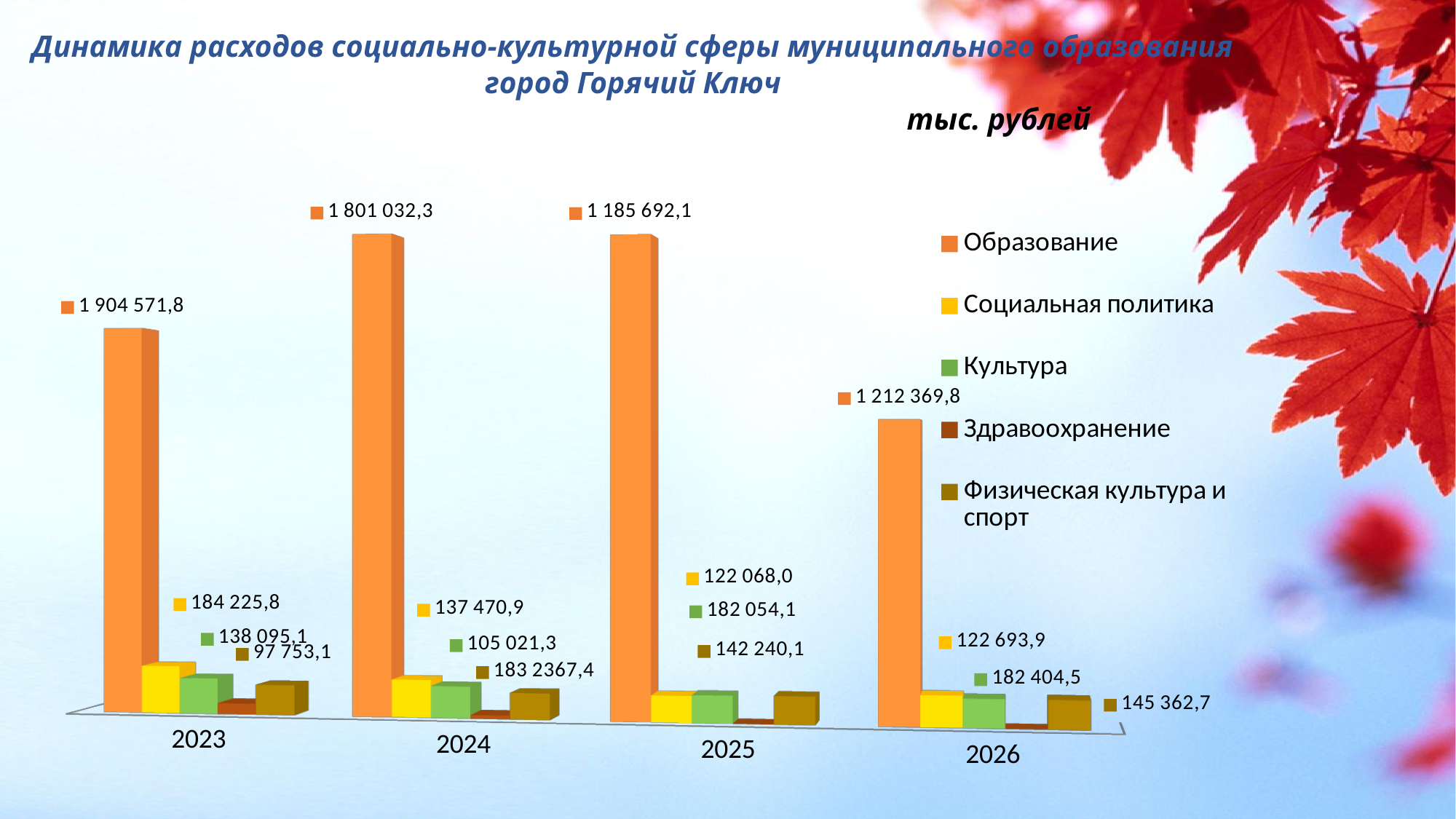
What is the value for Культура in 2025? 182 054,1 What is the difference between the Образование values for 2023 and 2024? 103 539,5 What kind of chart is shown on the slide? Bar chart Which is larger: Социальная политика in 2023 or in 2024? 2023 What is the value for Физическая культура и спорт in 2026? 145 362,7 What is the value for Образование in 2023? 1 904 571,8 Does the value for Социальная политика rise or fall from 2023 to 2025? Fall What is the value for Социальная политика in 2024? 137 470,9 How many years are shown on the x axis? 4 How many series does the legend list? 5